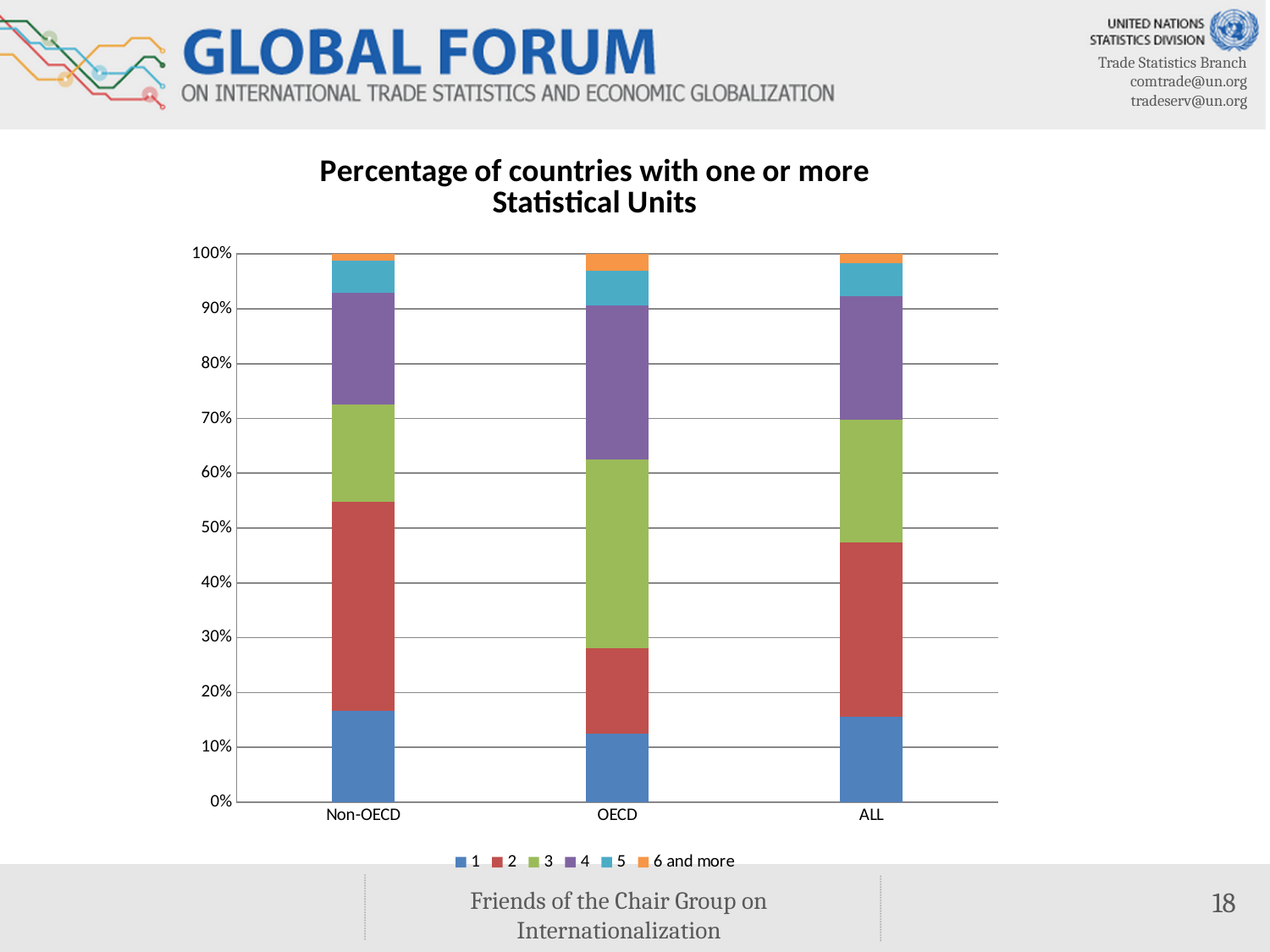
What is the title of the chart? Percentage of countries with one or more Statistical Units Is the value for series 3 in the OECD bar greater or less than 30%? greater Is the value for series 2 in the OECD bar greater or less than 20%? less Which series has the largest segment in the Non-OECD bar? 2 What kind of chart is shown on the slide? Stacked bar chart Which series has the largest segment in the OECD bar? 3 Is the value for series 1 in the Non-OECD bar greater or less than 20%? less How many categories are shown on the x axis? 3 How many series does the legend list? 6 Is the series 2 segment larger for Non-OECD or for OECD? Non-OECD Which legend entry is shown in orange? 6 and more